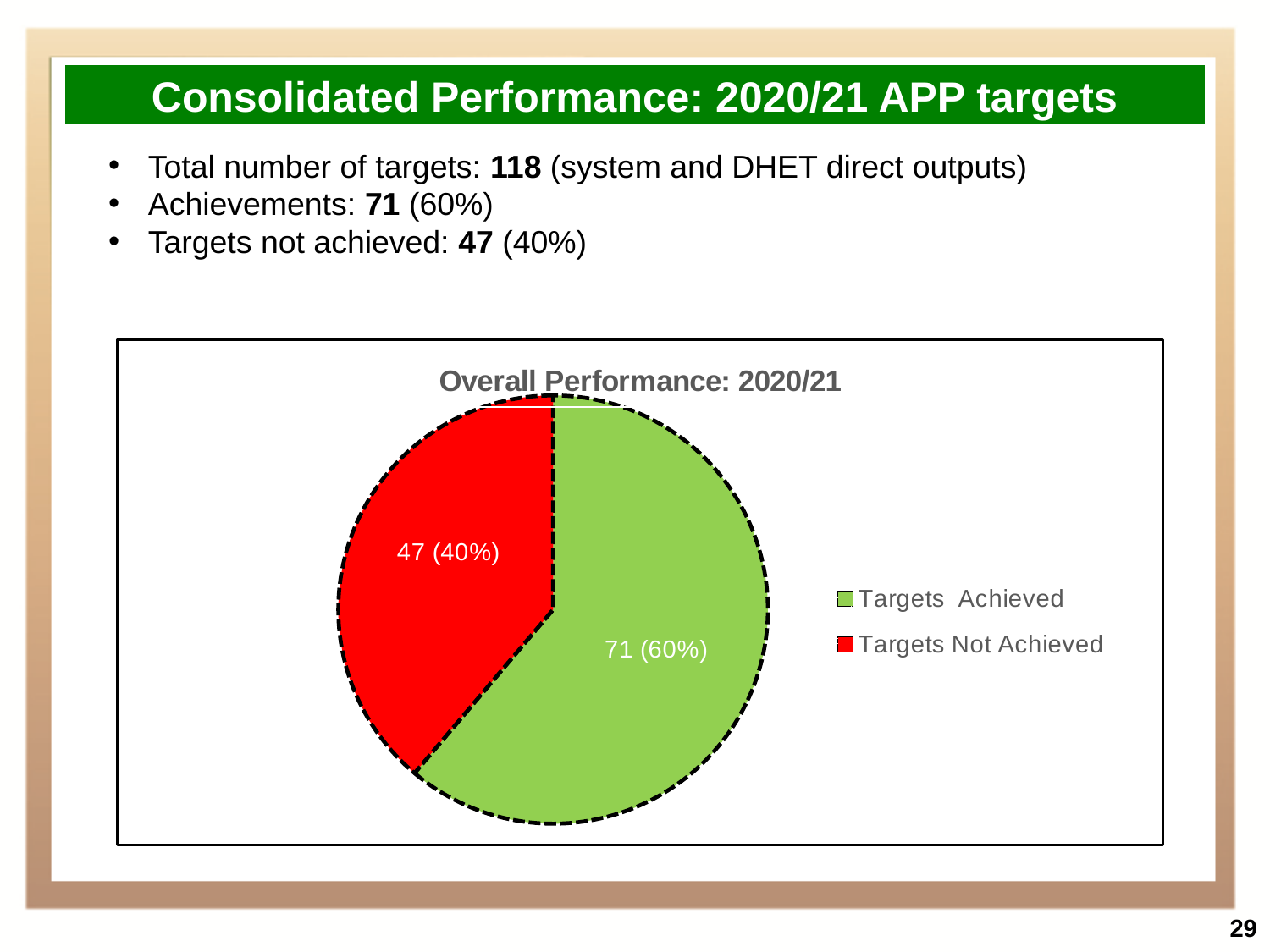
What share of the pie does the Targets Achieved slice represent? 60% What is the data label shown on the Targets Achieved slice? 71 (60%) Which slice is the largest in the pie chart? Targets Achieved How many slices does the pie chart have? 2 What is the title of the chart? Overall Performance: 2020/21 Which colour represents Targets Not Achieved in the pie chart? Red What kind of chart is shown on the slide? Pie chart What is the data label shown on the Targets Not Achieved slice? 47 (40%) Which slice is the smallest in the pie chart? Targets Not Achieved How many entries does the legend list? 2 What is the difference between the number of Targets Achieved and Targets Not Achieved? 24 What share of the pie does the Targets Not Achieved slice represent? 40%